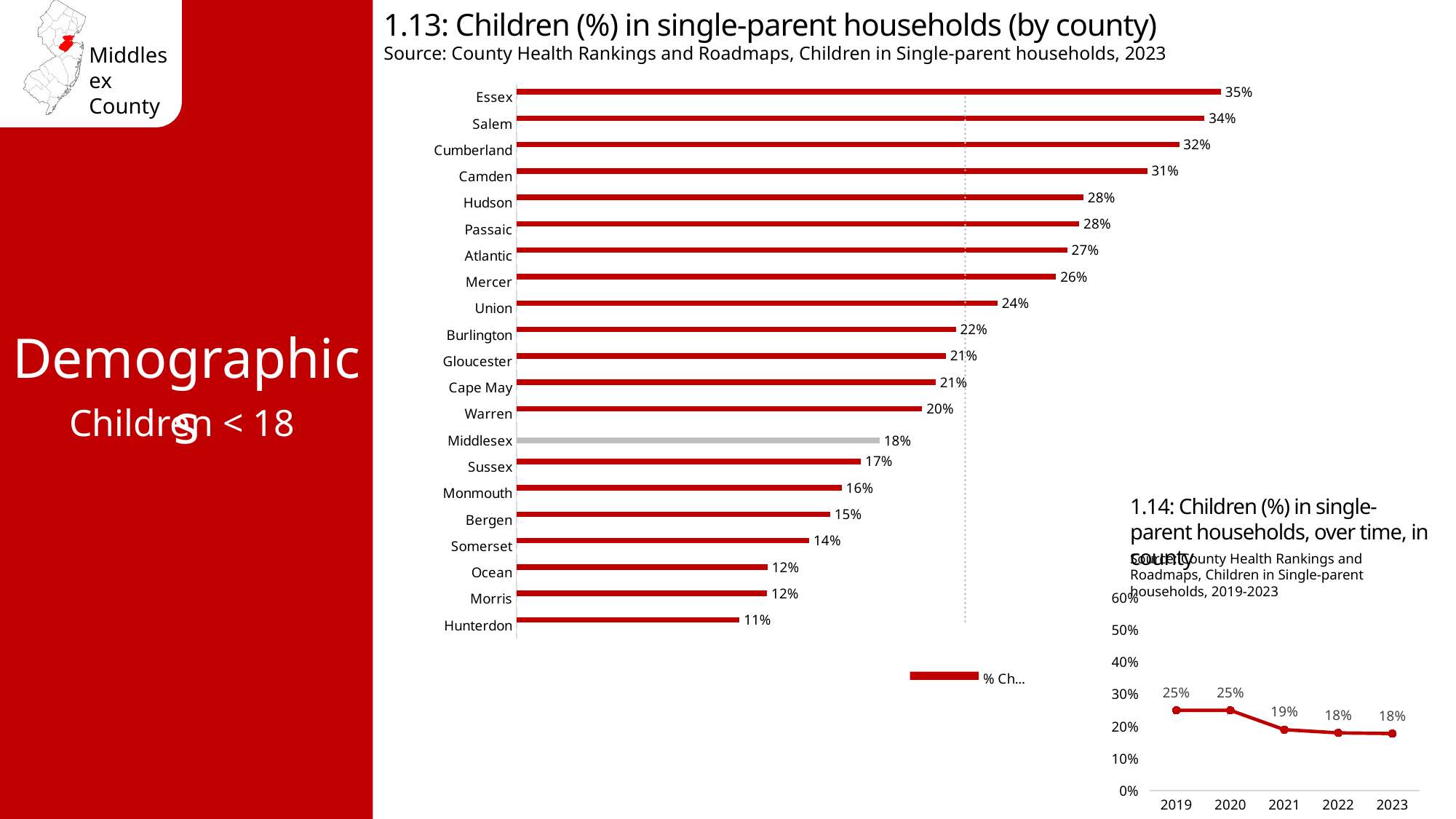
In chart 1.13 (by county), what is the difference between the values for Essex and Middlesex? 17 percentage points In chart 1.14 (over time), what is the difference between the 2019 value and the 2023 value? 7 percentage points In chart 1.13 (by county), what is the value for Camden? 31% What type of chart is chart 1.13 (Children (%) in single-parent households by county)? Bar chart In chart 1.13 (by county), which county has the highest percentage of children in single-parent households? Essex In chart 1.14 (Children (%) in single-parent households over time), what is the value for 2021? 19% What type of chart is chart 1.14 (Children (%) in single-parent households over time)? Line chart In chart 1.13 (by county), which county has the lowest percentage of children in single-parent households? Hunterdon In chart 1.13 (Children (%) in single-parent households by county), what is the value for Middlesex? 18% In chart 1.13 (by county), which is larger, the value for Union or the value for Bergen? Union In chart 1.14 (over time), do the values rise or fall from 2019 to 2023? Fall In chart 1.13 (by county), how many counties are shown? 21